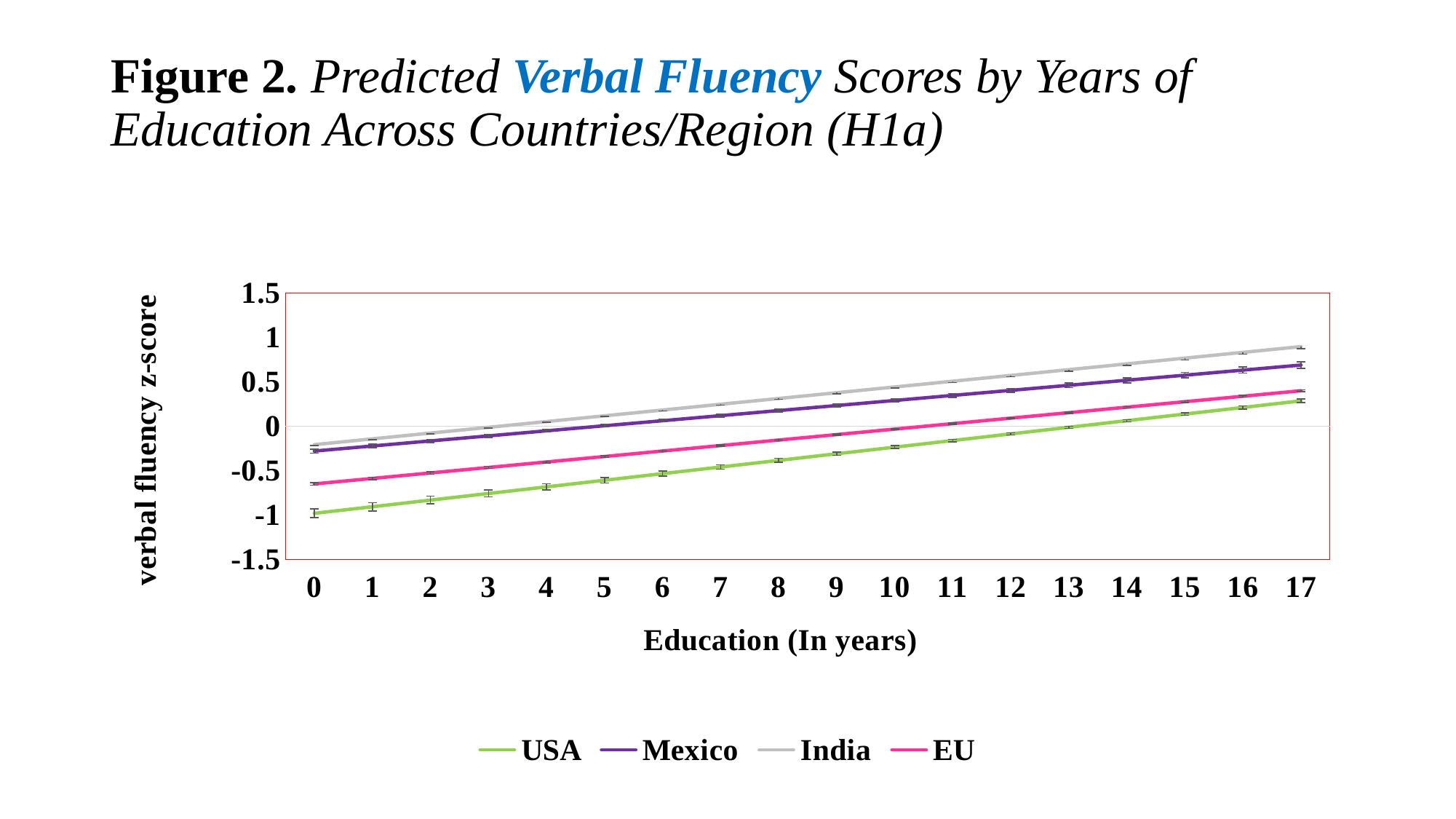
How many years-of-education values are marked along the x axis? 18 Do the verbal fluency z-scores rise or fall as years of education increase? rise How many series does the legend list? 4 Is the value for India at 17 years of education greater or less than 0.5? greater Is the value for Mexico at 0 years of education greater or less than 0? less What is the title of the x axis? Education (In years) Is the value for USA at 17 years of education greater or less than 0? greater Which country/region has the lowest predicted verbal fluency z-score at 0 years of education? USA At 17 years of education, which has the larger predicted z-score, India or USA? India Which country/region has the highest predicted verbal fluency z-score at 17 years of education? India What kind of chart is shown on the slide? line chart